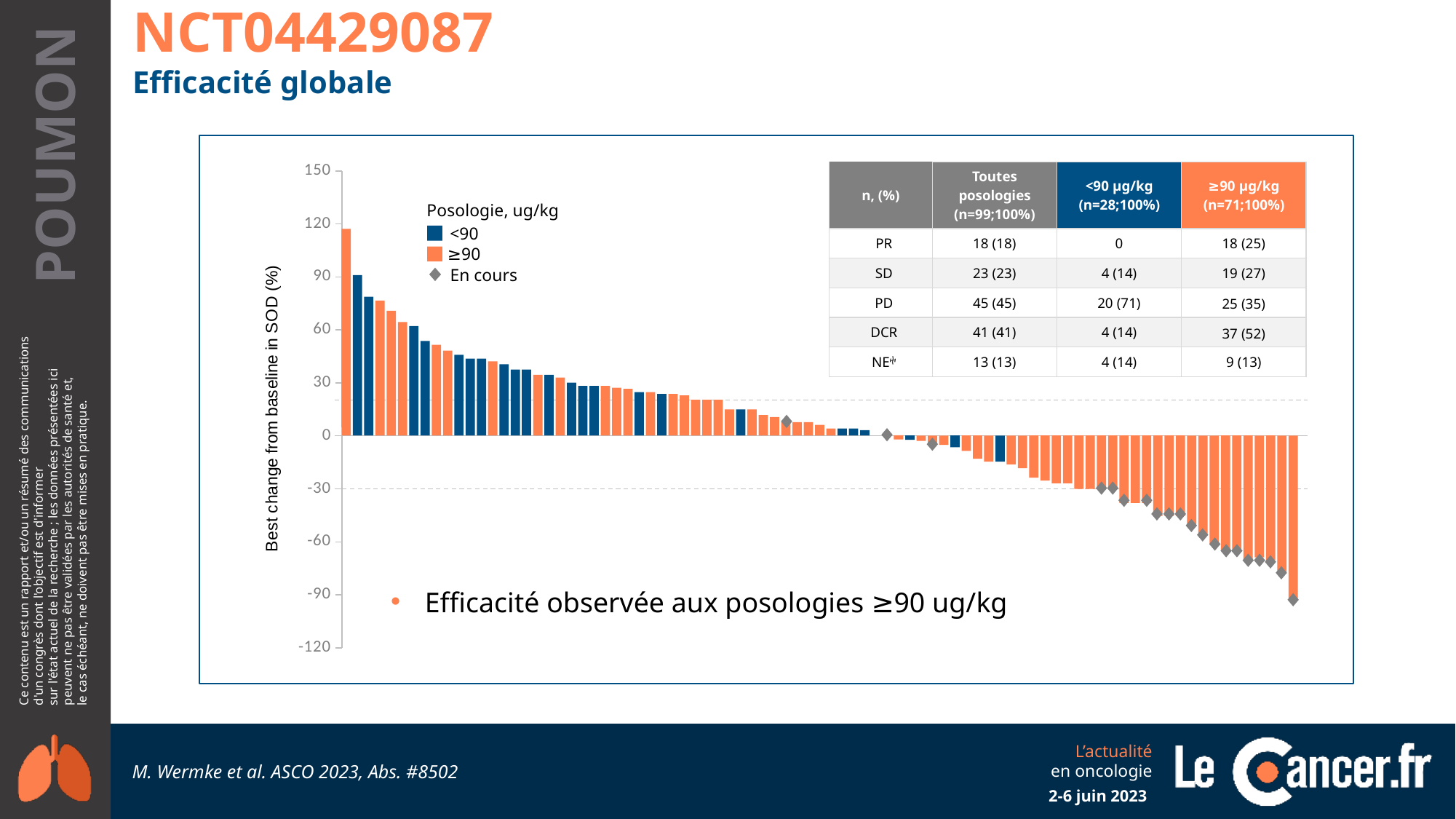
Is the value of the rightmost bar greater or less than -30? less How many entries does the chart legend list? 3 What is the label of the vertical axis of the chart? Best change from baseline in SOD (%) What is the title of the chart legend? Posologie, ug/kg Is the value of the tallest bar in the chart greater or less than 90? greater Do the bar values rise or fall from left to right along the x axis? fall What kind of chart is shown on the slide? bar chart Is the value of the lowest bar in the chart greater or less than -60? less